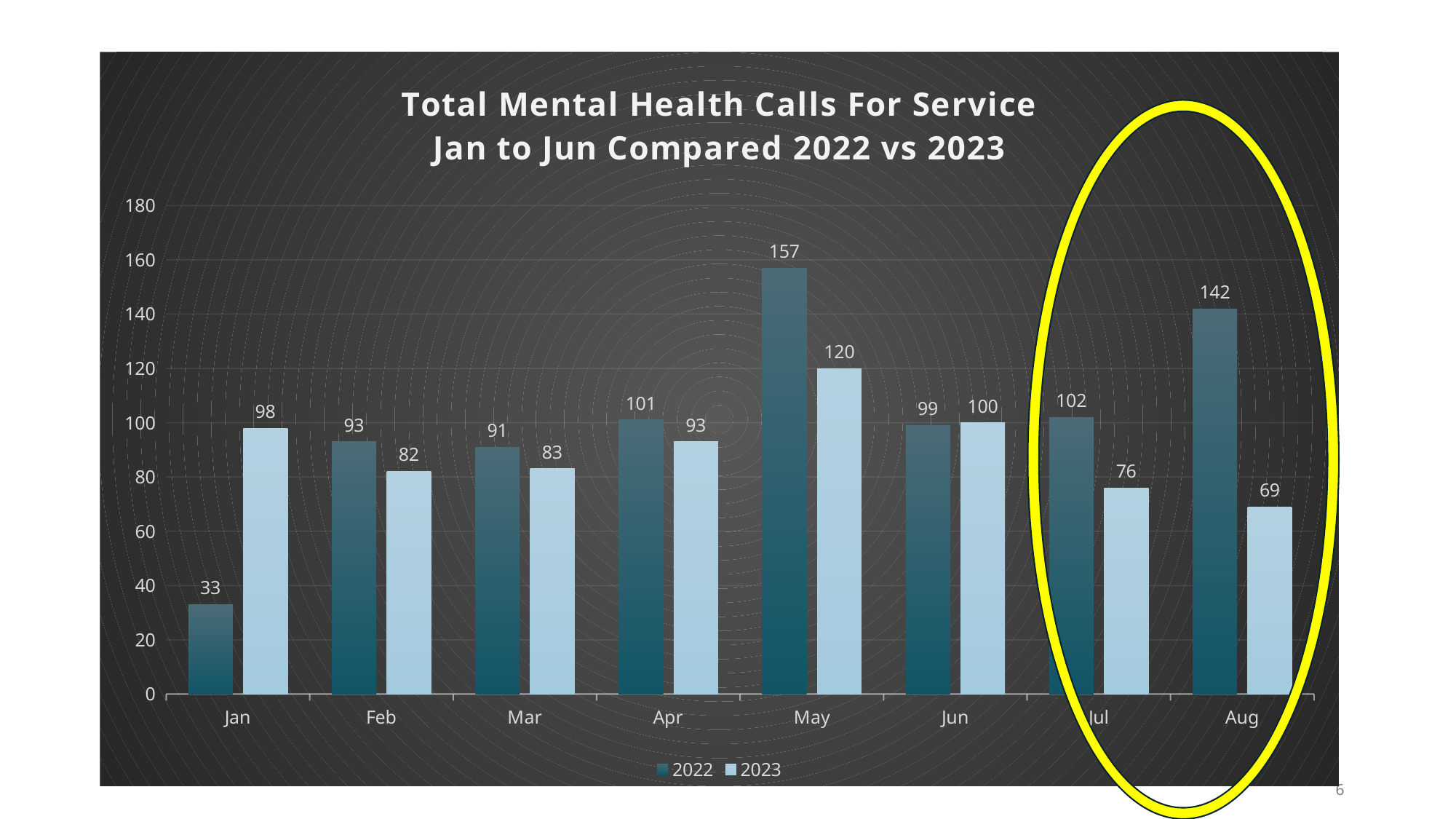
What kind of chart is shown on the slide? Bar chart What is the difference between the 2022 and 2023 values in Aug? 73 What is the value for 2022 in May? 157 What is the difference between the 2022 values for May and Jun? 58 What is the value for 2023 in Jul? 76 What is the value for 2022 in Jan? 33 Which months are highlighted by the yellow oval on the slide? Jul and Aug Which is larger in Jan, the 2022 value or the 2023 value? 2023 How many series does the legend list? 2 Which month has the highest value for the 2023 series? May How many months are shown on the x axis? 8 Which month has the lowest value for the 2022 series? Jan